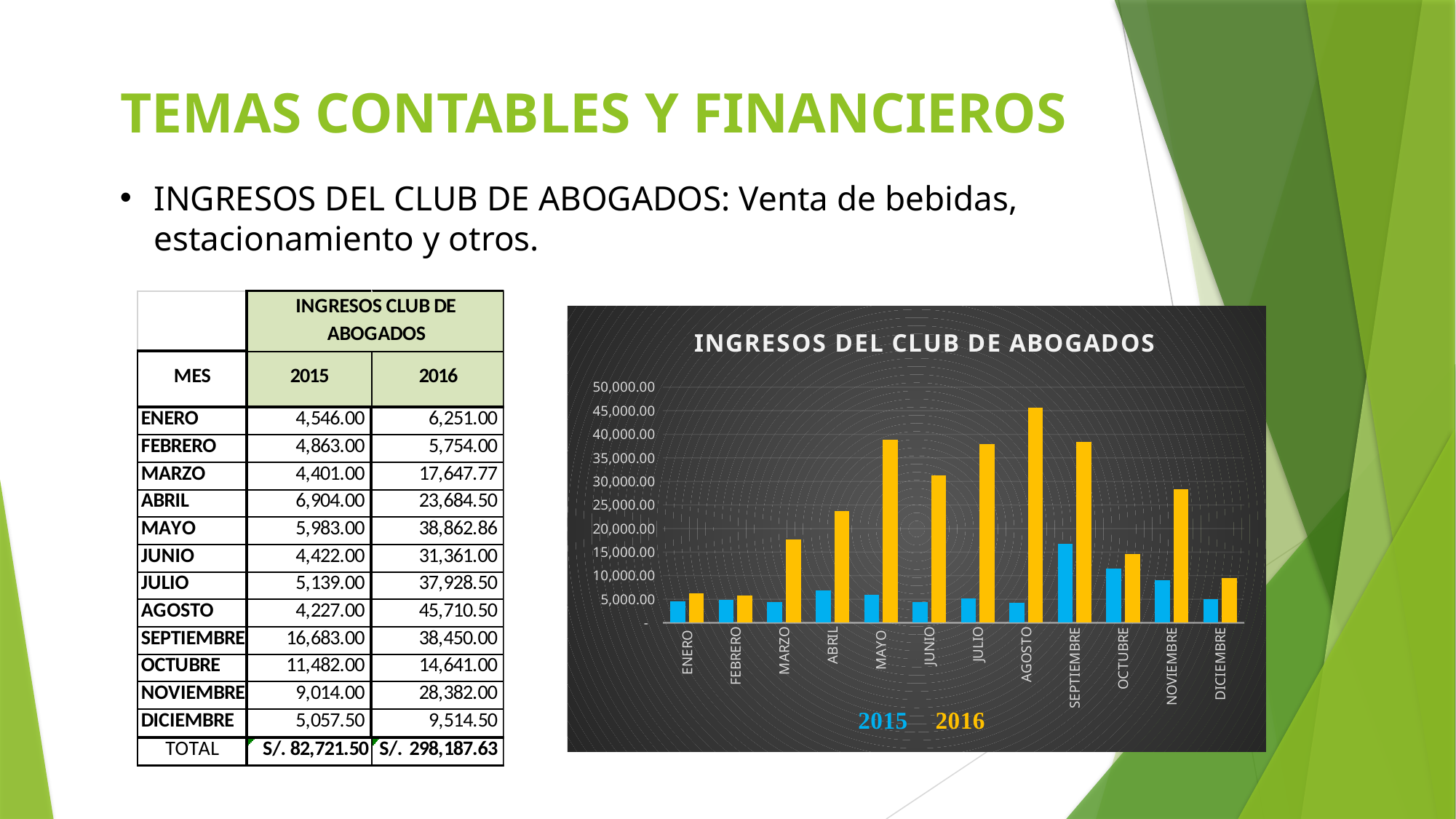
What is the title of the chart? INGRESOS DEL CLUB DE ABOGADOS Which month has the highest 2016 value in the chart? AGOSTO What kind of chart is shown on the slide? bar chart Is the 2016 value for AGOSTO greater or less than 40,000.00? greater What is the 2016 value for AGOSTO, as printed in the table on the slide? 45,710.50 In ENERO, which series has the larger value, 2015 or 2016? 2016 Is the 2016 value for JUNIO greater or less than 35,000.00? less Which month has the highest 2015 value in the chart? SEPTIEMBRE Which is larger in the chart, the 2016 value for OCTUBRE or the 2016 value for NOVIEMBRE? NOVIEMBRE Is the 2015 value for SEPTIEMBRE greater or less than 15,000.00? greater How many months are shown along the x axis of the chart? 12 How many series does the legend of the chart list? 2